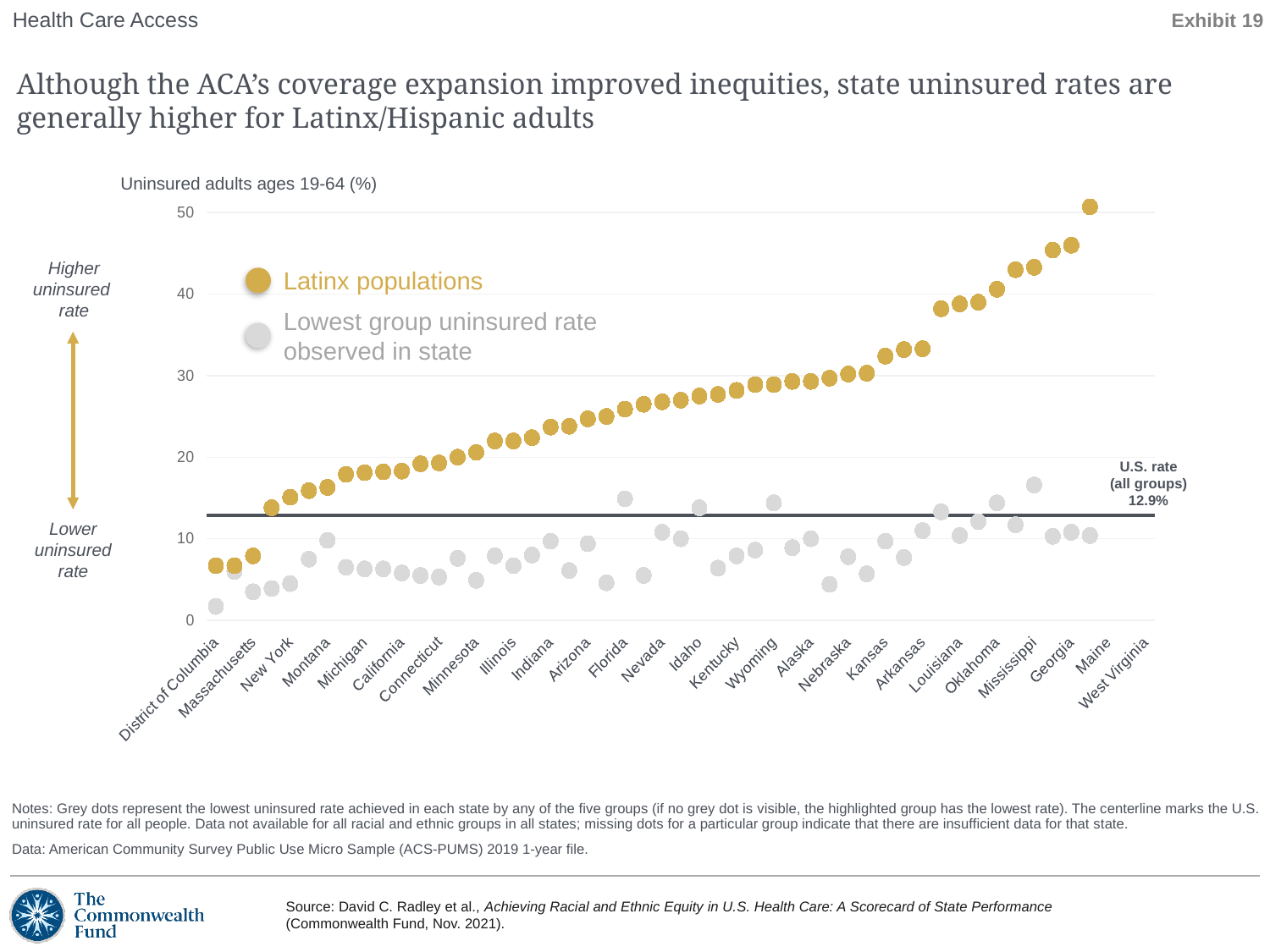
Is the Latinx population uninsured rate for District of Columbia greater or less than 10? less What is the title of the y axis? Uninsured adults ages 19-64 (%) Which has the larger Latinx population uninsured rate, Florida or Michigan? Florida Is the Latinx population uninsured rate for Florida greater or less than 20? greater What kind of chart is shown on the slide? Dot (scatter) chart How many series does the legend list? 2 Is the Latinx population uninsured rate for Louisiana greater or less than 30? greater What U.S. uninsured rate for all groups is marked by the centerline? 12.9% Do the Latinx population uninsured rates rise or fall from left to right along the x axis? Rise